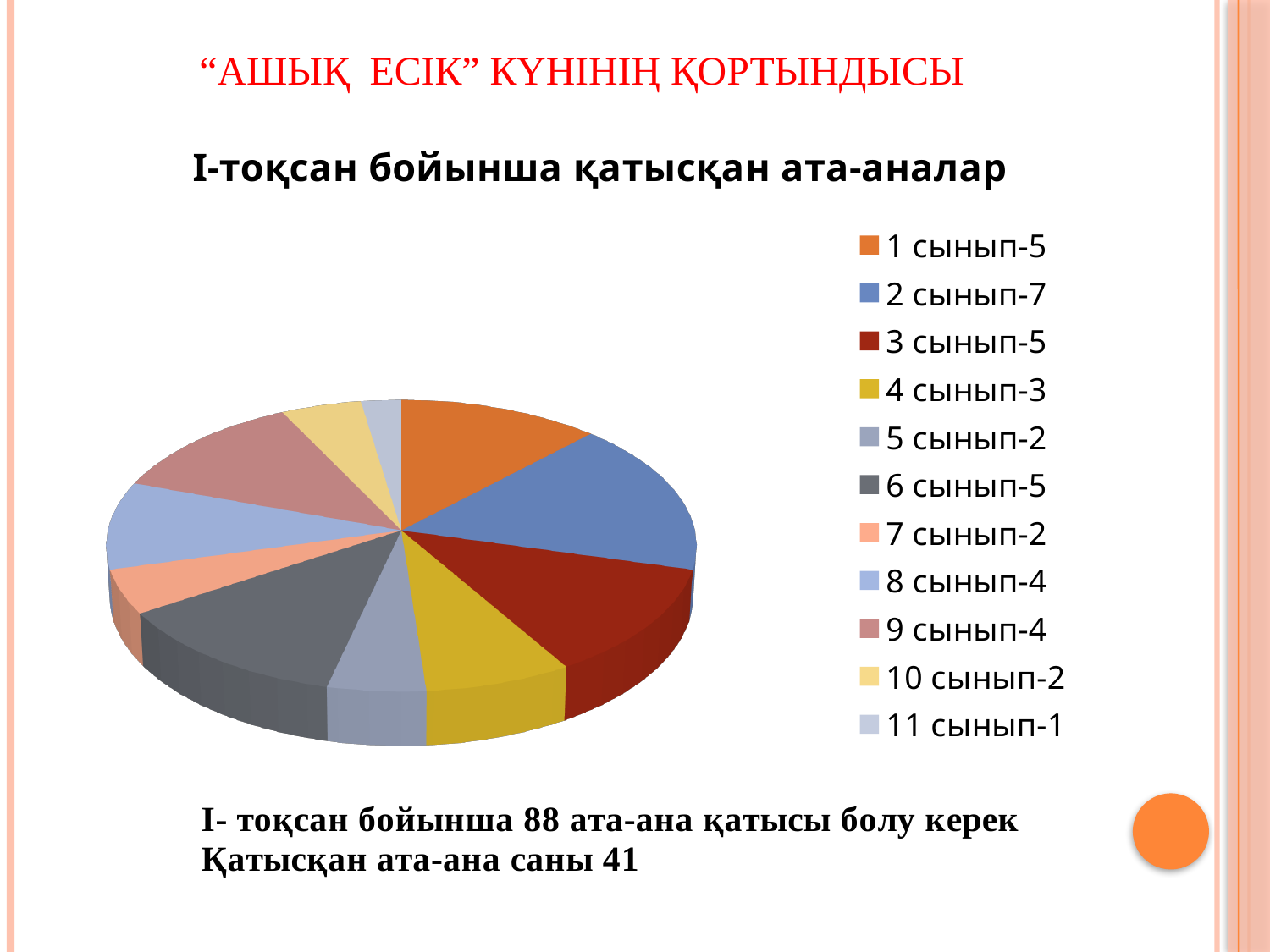
According to the legend, how many parents attended from 2 сынып? 7 How many categories (classes) does the pie chart show? 11 Which is larger, the value for 8 сынып or the value for 5 сынып? 8 сынып What is the title of the chart? І-тоқсан бойынша қатысқан ата-аналар What is the difference between the values for 2 сынып and 4 сынып? 4 What kind of chart is shown on the slide? pie chart Which class has the smallest slice of the pie chart? 11 сынып According to the legend, how many parents attended from 11 сынып? 1 What colour is the slice for 4 сынып in the pie chart? yellow Which class has the largest slice of the pie chart? 2 сынып According to the legend, how many parents attended from 4 сынып? 3 What is the difference between the values for 1 сынып and 11 сынып? 4